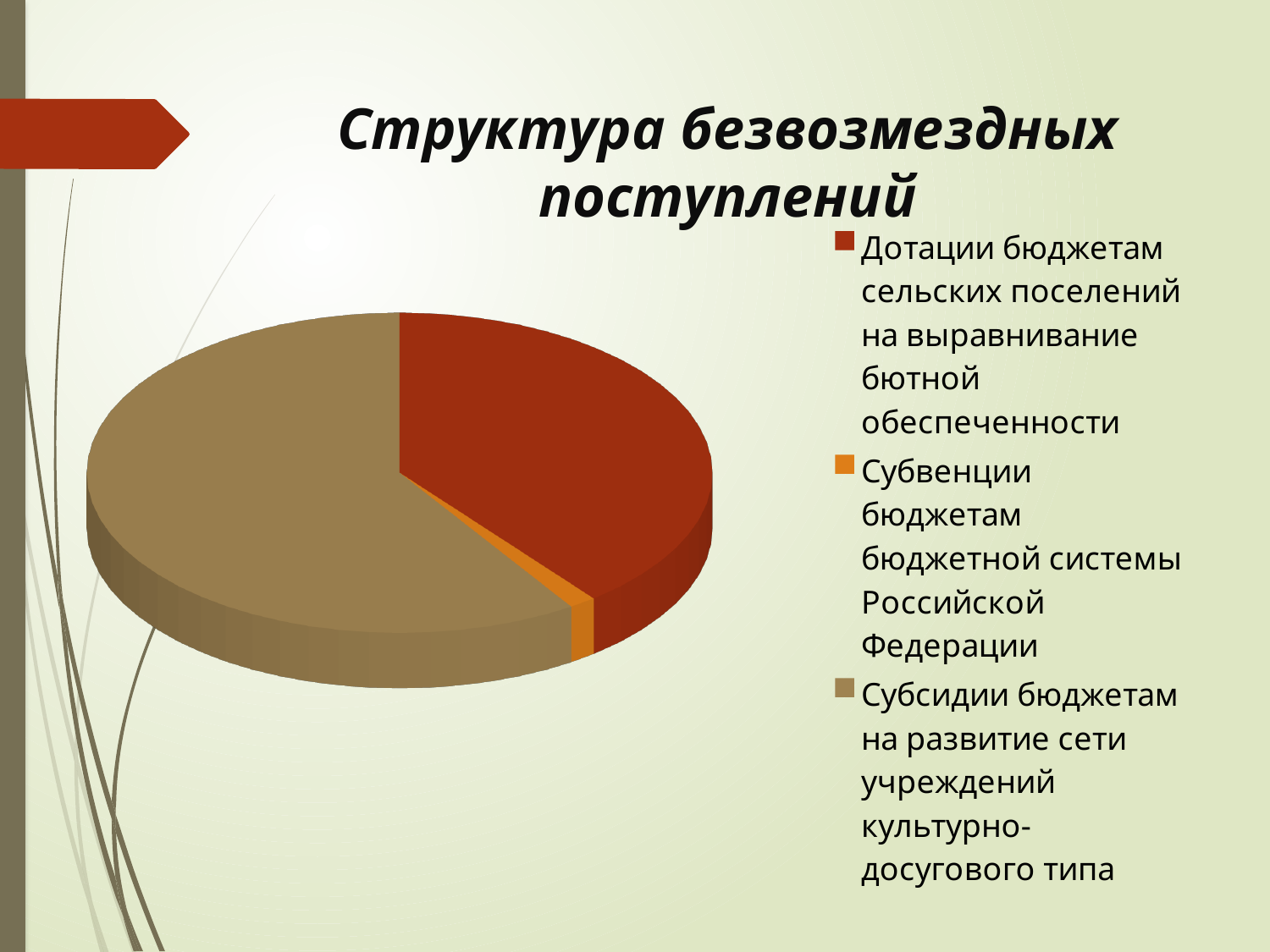
Which category has the largest slice of the pie? Субсидии бюджетам на развитие сети учреждений культурно-досугового типа How many slices does the pie chart have? 3 Which slice is larger: Дотации бюджетам сельских поселений на выравнивание бюджетной обеспеченности or Субвенции бюджетам бюджетной системы Российской Федерации? Дотации бюджетам сельских поселений на выравнивание бютной обеспеченности Which category has the smallest slice of the pie? Субвенции бюджетам бюджетной системы Российской Федерации Which slice is larger: Субсидии бюджетам на развитие сети учреждений культурно-досугового типа or Дотации бюджетам сельских поселений на выравнивание бюджетной обеспеченности? Субсидии бюджетам на развитие сети учреждений культурно-досугового типа What is the title of the chart on the slide? Структура безвозмездных поступлений How many entries does the legend list? 3 What kind of chart is shown on the slide? Pie chart What colour is the slice for Субвенции бюджетам бюджетной системы Российской Федерации? Orange